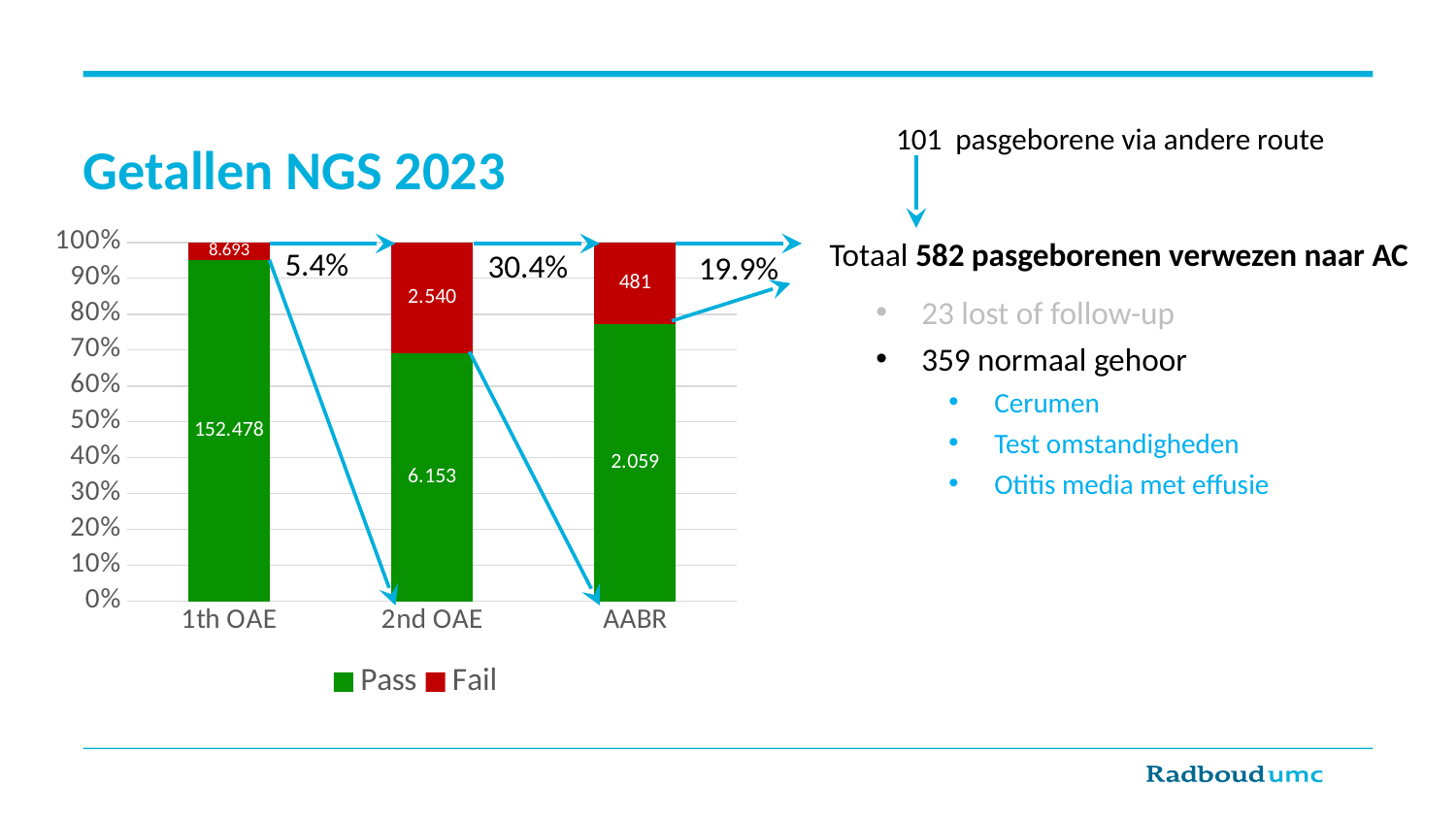
What is the total of the Pass and Fail values for AABR? 2.540 How many categories are shown on the x axis of the chart? 3 Is the Pass share of the AABR bar greater or less than 70%? greater What is the Fail value for AABR? 481 What is the difference between the Pass and Fail values for 2nd OAE? 3.613 What is the Pass value for AABR? 2.059 What type of chart is shown on the slide? Stacked bar chart What is the Pass value for 1th OAE? 152.478 How many series does the chart legend list? 2 What is the Fail value for 2nd OAE? 2.540 Which category has the lowest Fail value? AABR Which category has the highest Pass value? 1th OAE